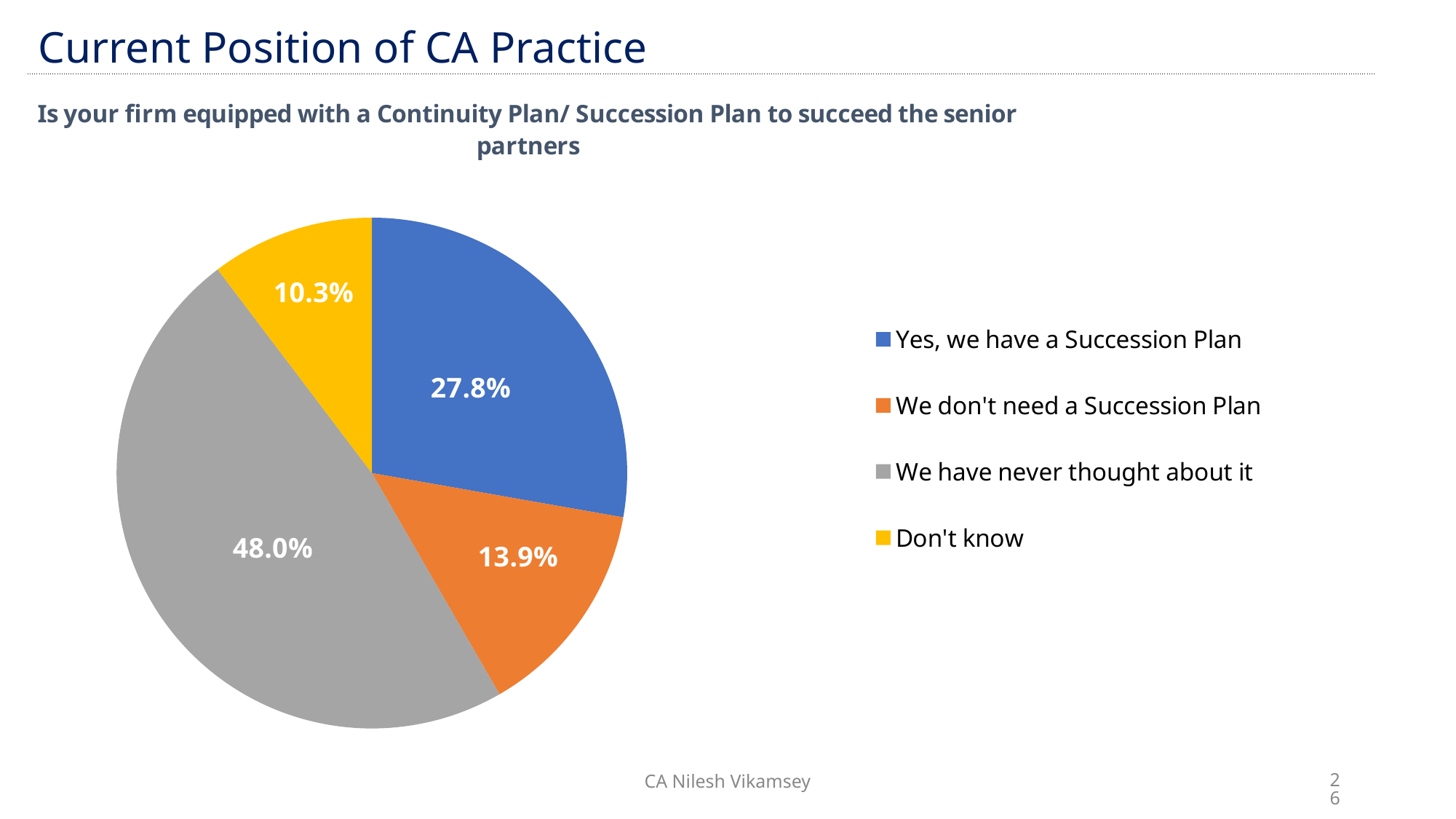
How many slices does the pie chart have? 4 What question does the chart title ask? Is your firm equipped with a Continuity Plan/ Succession Plan to succeed the senior partners What share of respondents said "We have never thought about it"? 48.0% Which is larger: the share for "We don't need a Succession Plan" or the share for "Don't know"? We don't need a Succession Plan What share of respondents said "Don't know"? 10.3% What is the difference in percentage points between "We have never thought about it" and "Yes, we have a Succession Plan"? 20.2 percentage points What share of respondents said "Yes, we have a Succession Plan"? 27.8% What share of respondents said "We don't need a Succession Plan"? 13.9% What colour is the slice for "We have never thought about it"? grey Which response has the smallest share of the pie? Don't know What kind of chart is shown on the slide? pie chart Which response has the largest share of the pie? We have never thought about it